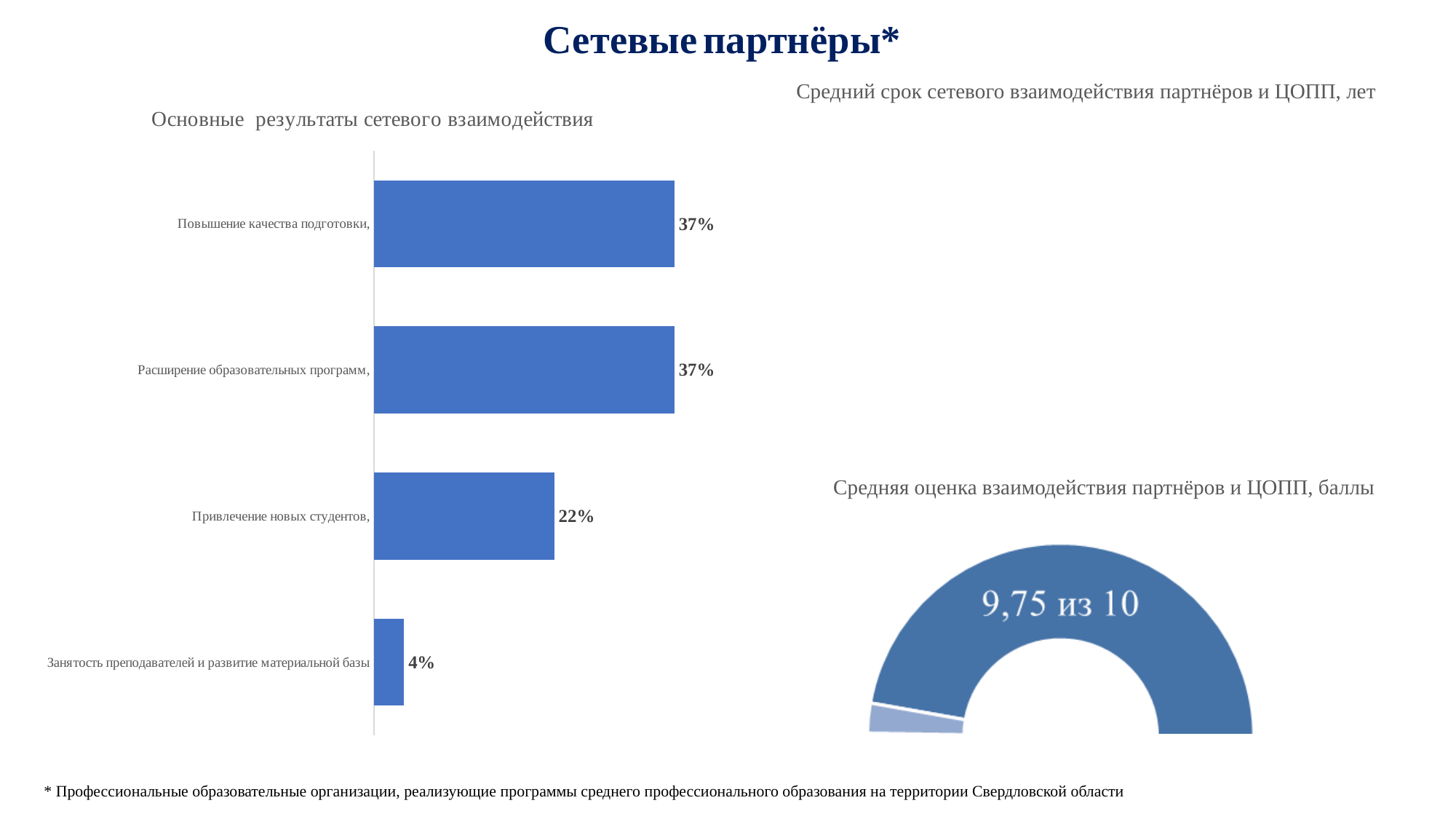
In the chart 'Основные результаты сетевого взаимодействия', what is the difference between 'Привлечение новых студентов' and 'Занятость преподавателей и развитие материальной базы'? 18% In the chart 'Основные результаты сетевого взаимодействия', what is the value for 'Привлечение новых студентов'? 22% In the chart 'Основные результаты сетевого взаимодействия', what is the value for 'Занятость преподавателей и развитие материальной базы'? 4% In the chart 'Основные результаты сетевого взаимодействия', what is the difference between 'Повышение качества подготовки' and 'Привлечение новых студентов'? 15% In the chart 'Основные результаты сетевого взаимодействия', what is the value for 'Расширение образовательных программ'? 37% In the chart 'Основные результаты сетевого взаимодействия', what is the value for 'Повышение качества подготовки'? 37% In the chart 'Основные результаты сетевого взаимодействия', which is larger: 'Привлечение новых студентов' or 'Занятость преподавателей и развитие материальной базы'? Привлечение новых студентов What kind of chart is 'Средняя оценка взаимодействия партнёров и ЦОПП, баллы'? Doughnut chart In the chart 'Основные результаты сетевого взаимодействия', which category has the lowest value? Занятость преподавателей и развитие материальной базы In the chart 'Средняя оценка взаимодействия партнёров и ЦОПП, баллы', what value is printed in the centre of the chart? 9,75 из 10 What kind of chart is 'Основные результаты сетевого взаимодействия'? Bar chart How many categories are shown in the chart 'Основные результаты сетевого взаимодействия'? 4